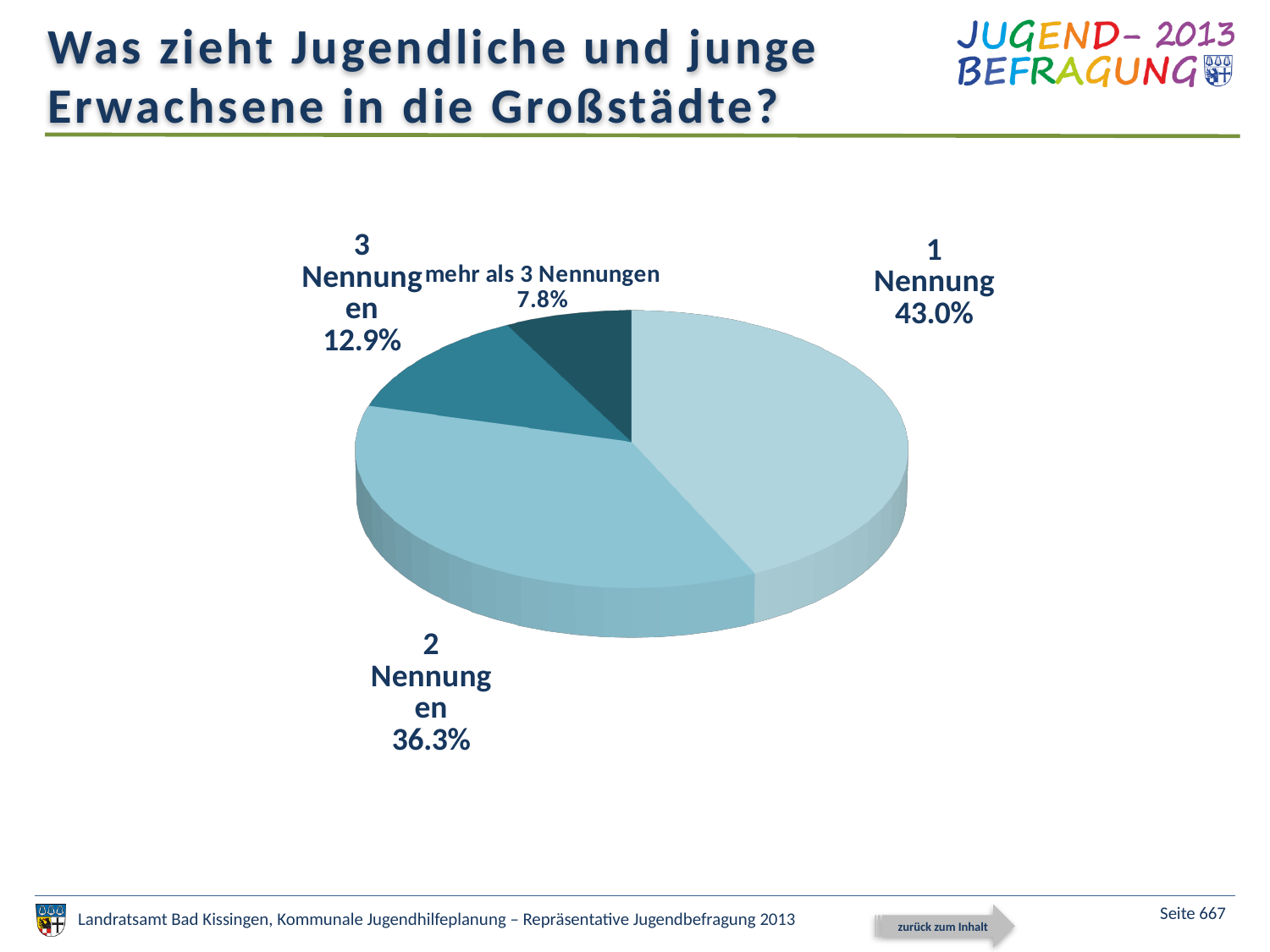
What share of the pie does "1 Nennung" have? 43.0% Which is larger, the share for "2 Nennungen" or the share for "3 Nennungen"? 2 Nennungen What is the title of the slide containing the pie chart? Was zieht Jugendliche und junge Erwachsene in die Großstädte? Which category has the largest slice of the pie? 1 Nennung Which category has the smallest slice of the pie? mehr als 3 Nennungen What share of the pie does "2 Nennungen" have? 36.3% What is the difference in percentage points between "1 Nennung" and "2 Nennungen"? 6.7 What share of the pie does "3 Nennungen" have? 12.9% What is the difference in percentage points between "3 Nennungen" and "mehr als 3 Nennungen"? 5.1 How many slices does the pie chart have? 4 What kind of chart is shown on the slide? pie chart